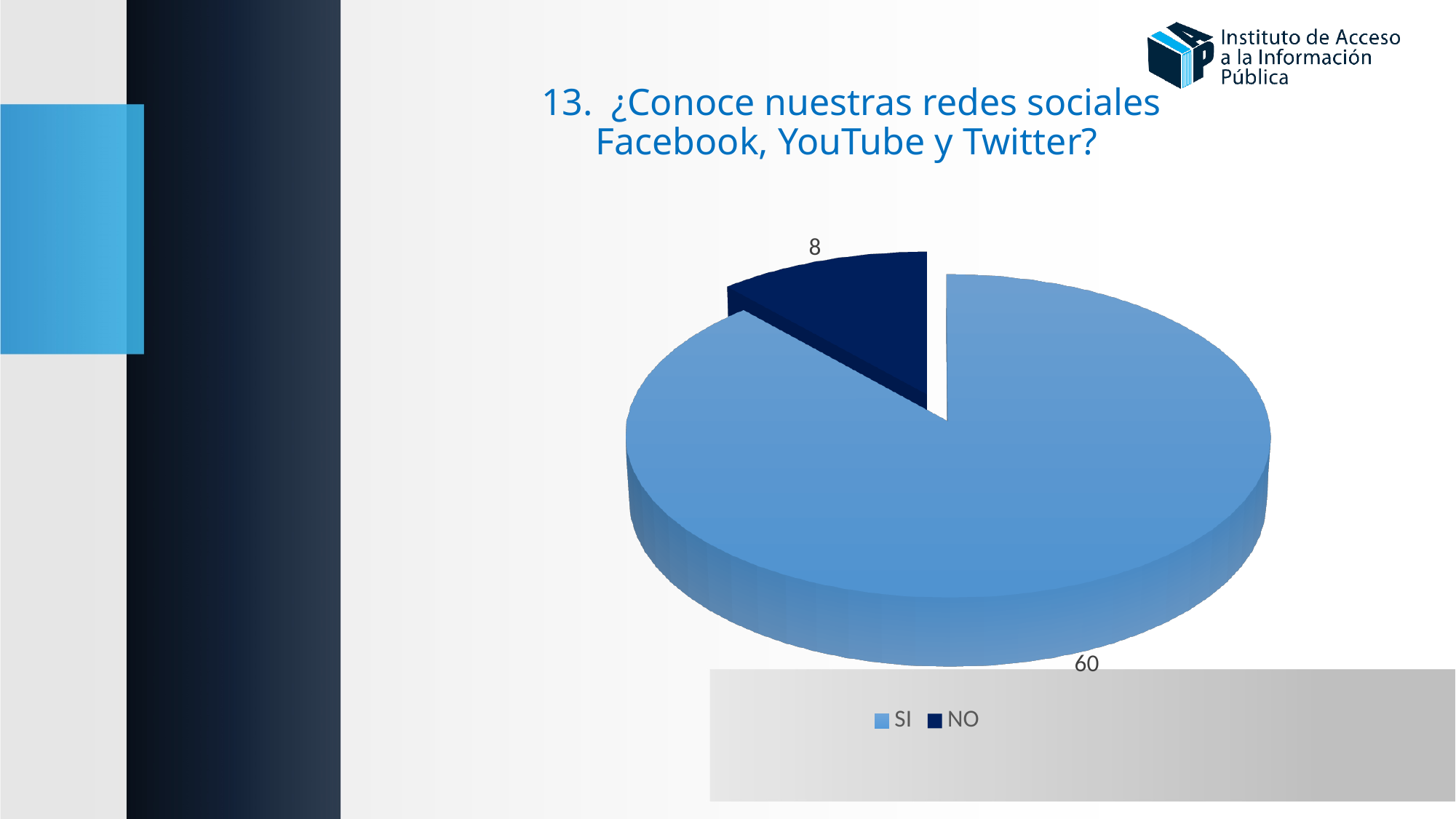
What is the difference between the SI and NO values? 52 Which category has the smallest slice? NO What is the title of the chart? 13. ¿Conoce nuestras redes sociales Facebook, YouTube y Twitter? Which category has the largest slice? SI What kind of chart is shown on the slide? Pie chart How many entries does the legend list? 2 What is the value for SI? 60 How many categories does the pie chart show? 2 What is the total of all slices in the pie chart? 68 What is the value for NO? 8 Which is larger, SI or NO? SI Which legend entry is shown in dark navy blue? NO